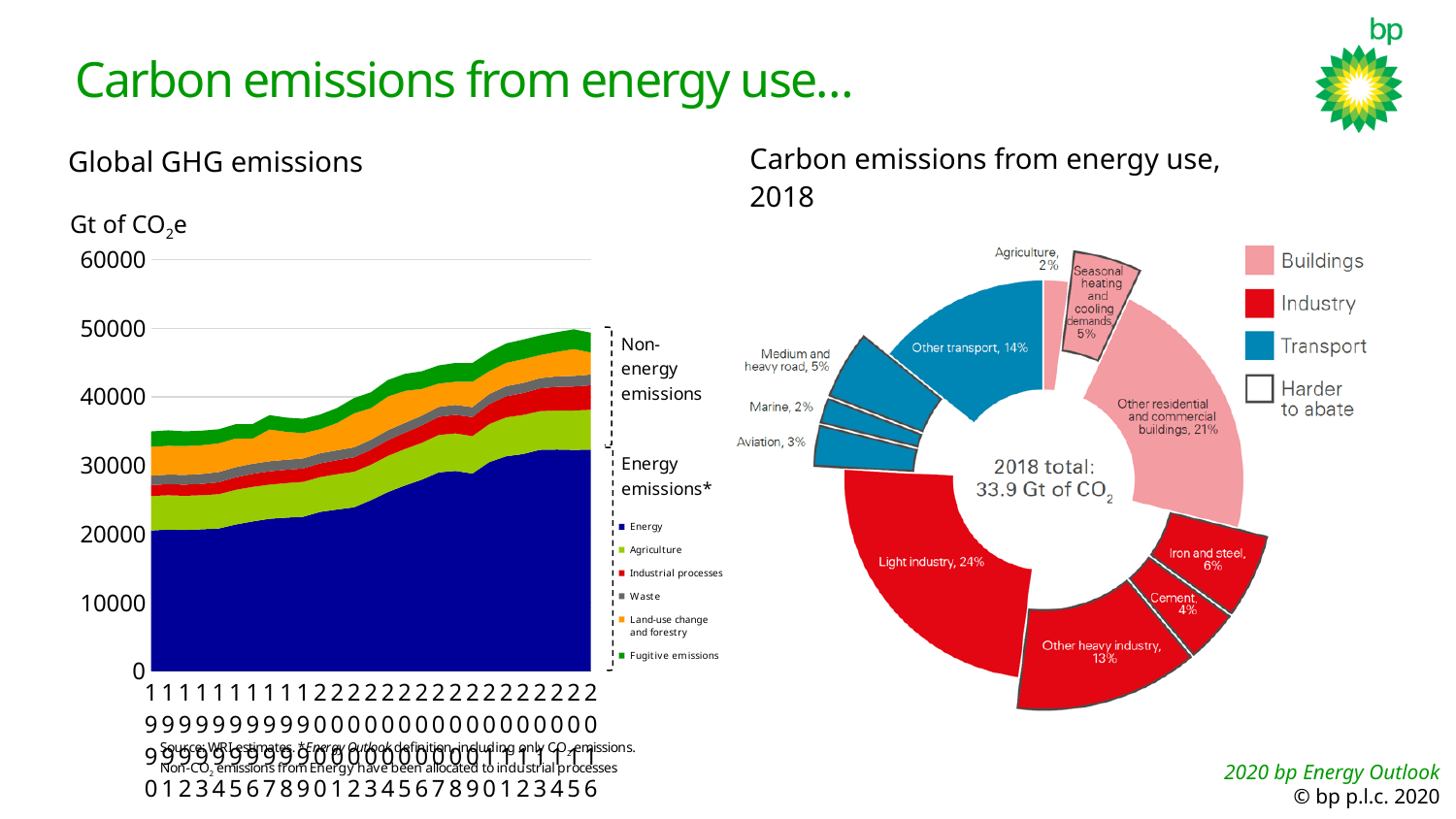
What is the 2018 total shown in the centre of the 'Carbon emissions from energy use, 2018' chart? 33.9 Gt of CO2 In the 'Global GHG emissions' chart, do total emissions rise or fall from 1990 to 2016? Rise What kind of chart is the 'Carbon emissions from energy use, 2018' chart on the right? Pie chart In the 'Carbon emissions from energy use, 2018' chart, which slice is the largest? Light industry In the 'Carbon emissions from energy use, 2018' chart, how many percentage points larger is Other residential and commercial buildings than Other heavy industry? 8 percentage points In the 'Global GHG emissions' chart, is the Energy value for 2016 greater or less than 30000? greater In the 'Carbon emissions from energy use, 2018' chart, how many slices are there? 11 In the 'Carbon emissions from energy use, 2018' chart, what share does Other transport have? 14% What kind of chart is the 'Global GHG emissions' chart on the left? Area chart In the 'Carbon emissions from energy use, 2018' chart, what share does Light industry have? 24% How many series does the legend of the 'Global GHG emissions' chart list? 6 In the 'Carbon emissions from energy use, 2018' chart, which is larger, Iron and steel or Cement? Iron and steel